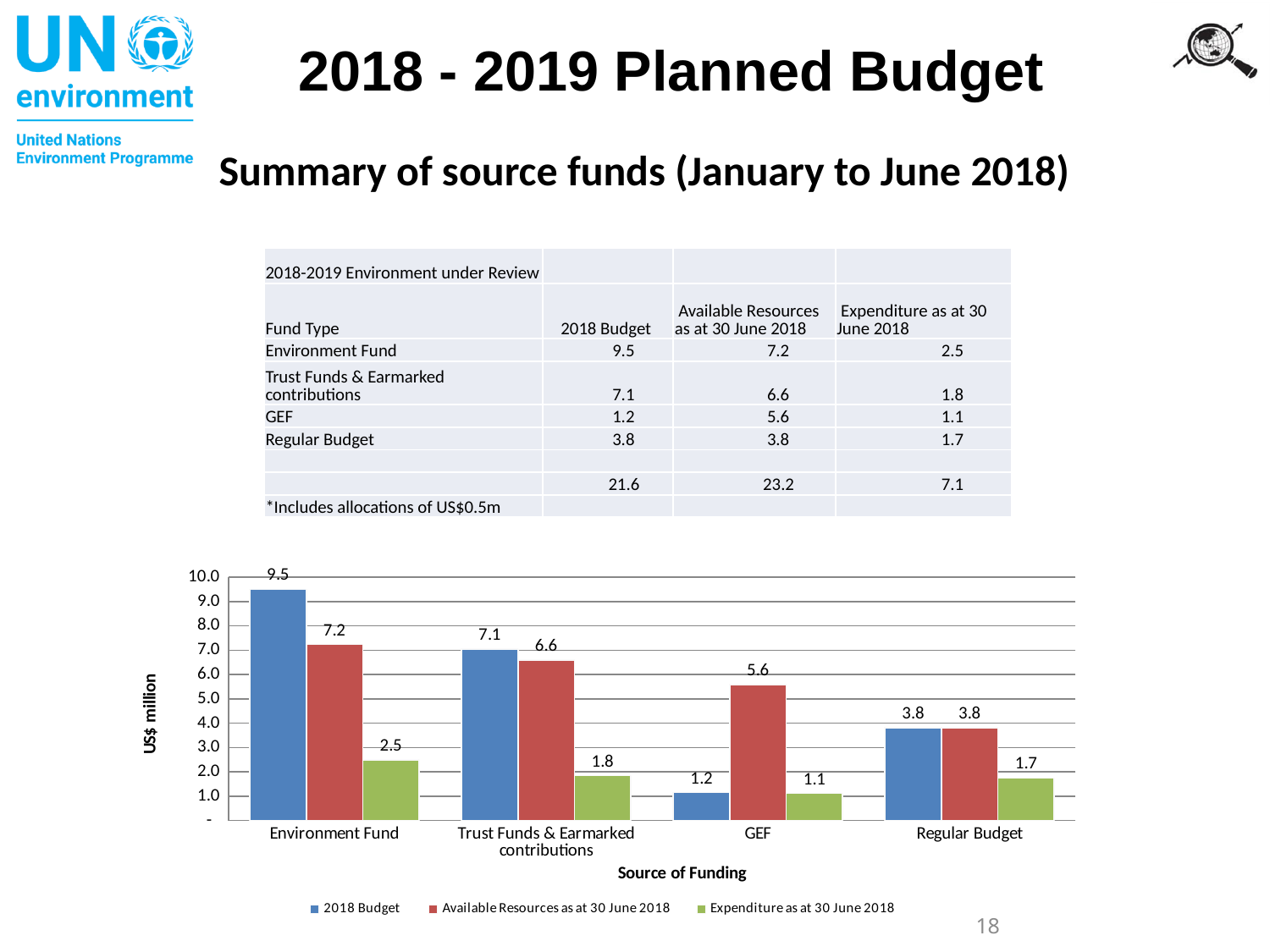
What is the Expenditure as at 30 June 2018 value for Trust Funds & Earmarked contributions in the chart? 1.8 What is the Available Resources as at 30 June 2018 value for GEF in the chart? 5.6 What is the 2018 Budget value for the Environment Fund in the chart? 9.5 Which colour represents the Expenditure as at 30 June 2018 series in the chart? Green In the chart, is the Available Resources as at 30 June 2018 value for GEF larger than its 2018 Budget value? Yes, 5.6 is larger than 1.2 How many series does the chart legend list? 3 What kind of chart is shown on the slide? Bar chart What is the difference between the 2018 Budget and the Expenditure as at 30 June 2018 for the Environment Fund in the chart? 7.0 How many sources of funding are shown on the x axis of the chart? 4 Which source of funding has the highest 2018 Budget value in the chart? Environment Fund What is the label of the vertical axis of the chart? US$ million Which source of funding has the lowest 2018 Budget value in the chart? GEF